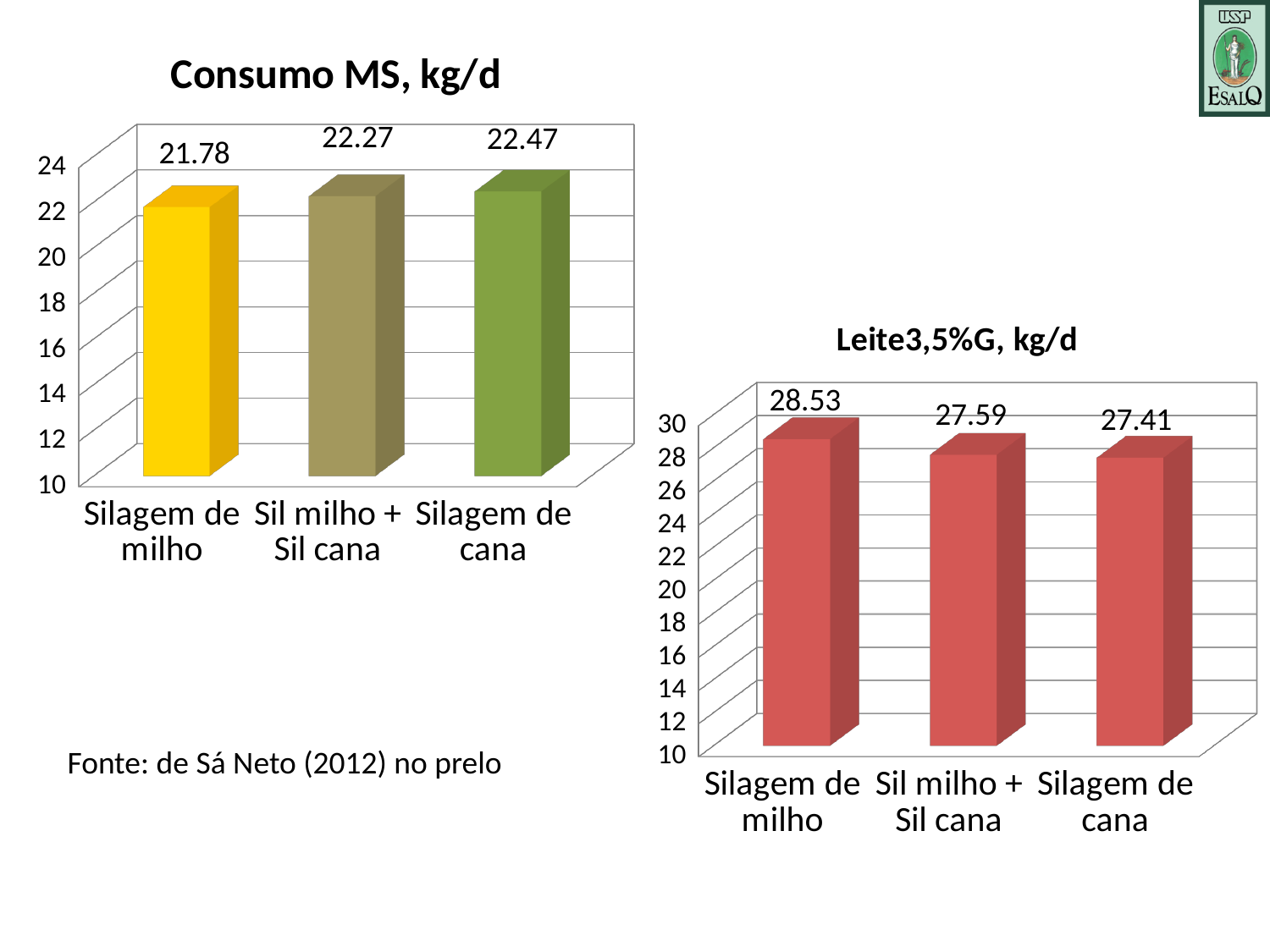
In the 'Leite3,5%G, kg/d' chart, what is the value for Silagem de milho? 28.53 In the 'Consumo MS, kg/d' chart, which category has the highest value? Silagem de cana In the 'Leite3,5%G, kg/d' chart, what is the value for Silagem de cana? 27.41 In the 'Leite3,5%G, kg/d' chart, what is the difference between Silagem de milho and Sil milho + Sil cana? 0.94 In the 'Consumo MS, kg/d' chart, which category has the lowest value? Silagem de milho In the 'Consumo MS, kg/d' chart, what is the value for Silagem de milho? 21.78 In the 'Consumo MS, kg/d' chart, what is the value for Sil milho + Sil cana? 22.27 What kind of chart is the 'Leite3,5%G, kg/d' chart? bar chart In the 'Consumo MS, kg/d' chart, what is the difference between Silagem de cana and Silagem de milho? 0.69 In the 'Leite3,5%G, kg/d' chart, do the values rise or fall from left to right along the x axis? fall In the 'Leite3,5%G, kg/d' chart, which category has the highest value? Silagem de milho How many categories are shown in the 'Consumo MS, kg/d' chart? 3